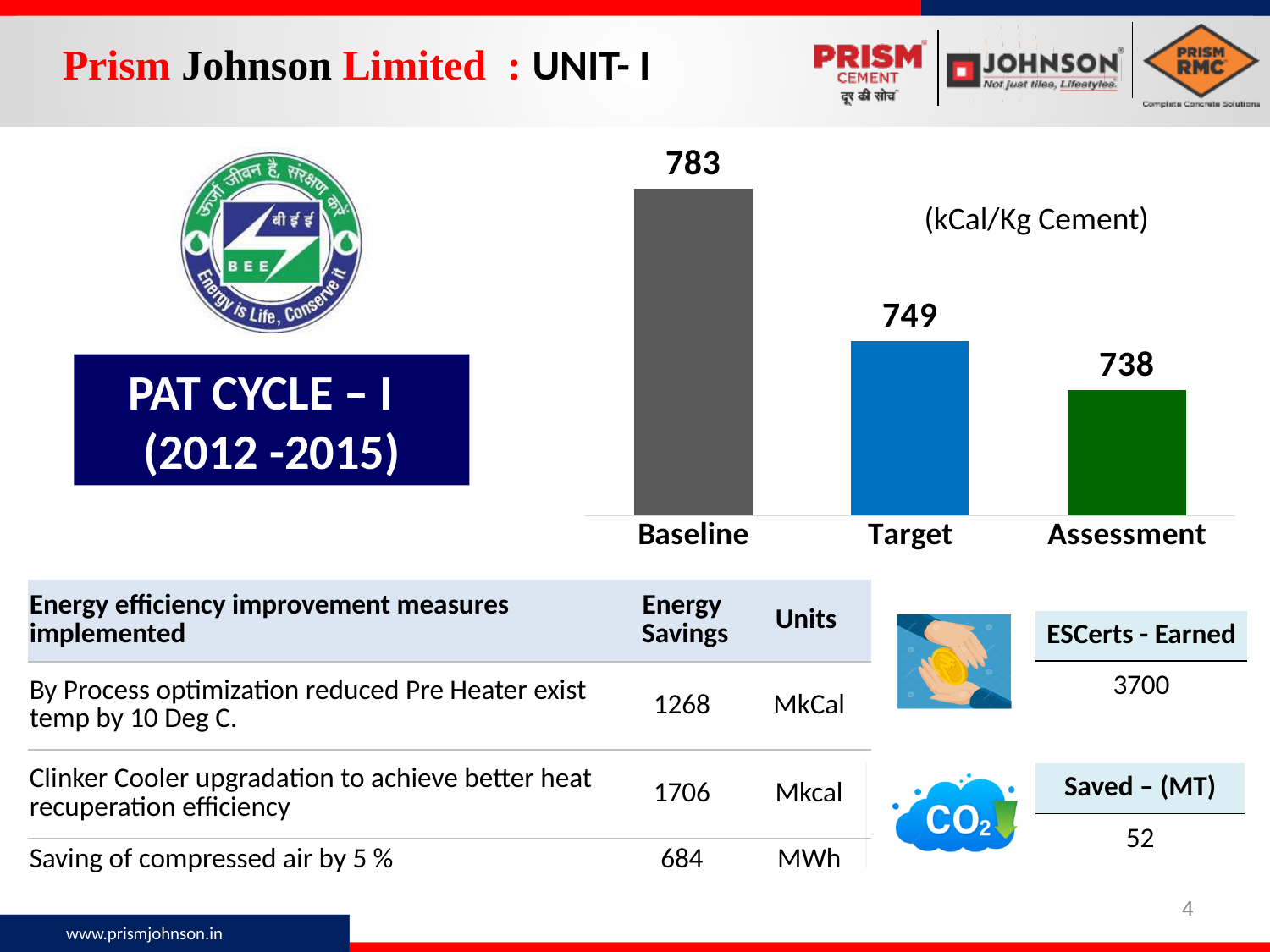
What unit is shown for the values in the bar chart? kCal/Kg Cement How many categories are shown in the bar chart? 3 What is the value for Assessment in the bar chart? 738 Which category has the highest value in the bar chart? Baseline What is the value for Baseline in the bar chart? 783 What kind of chart is shown on the slide? bar chart What is the difference between the Target and Assessment values? 11 Do the values rise or fall from Baseline to Assessment along the x axis? fall Which is larger, the Baseline value or the Target value? Baseline What is the value for Target in the bar chart? 749 What is the difference between the Baseline and Assessment values? 45 Which category has the lowest value in the bar chart? Assessment